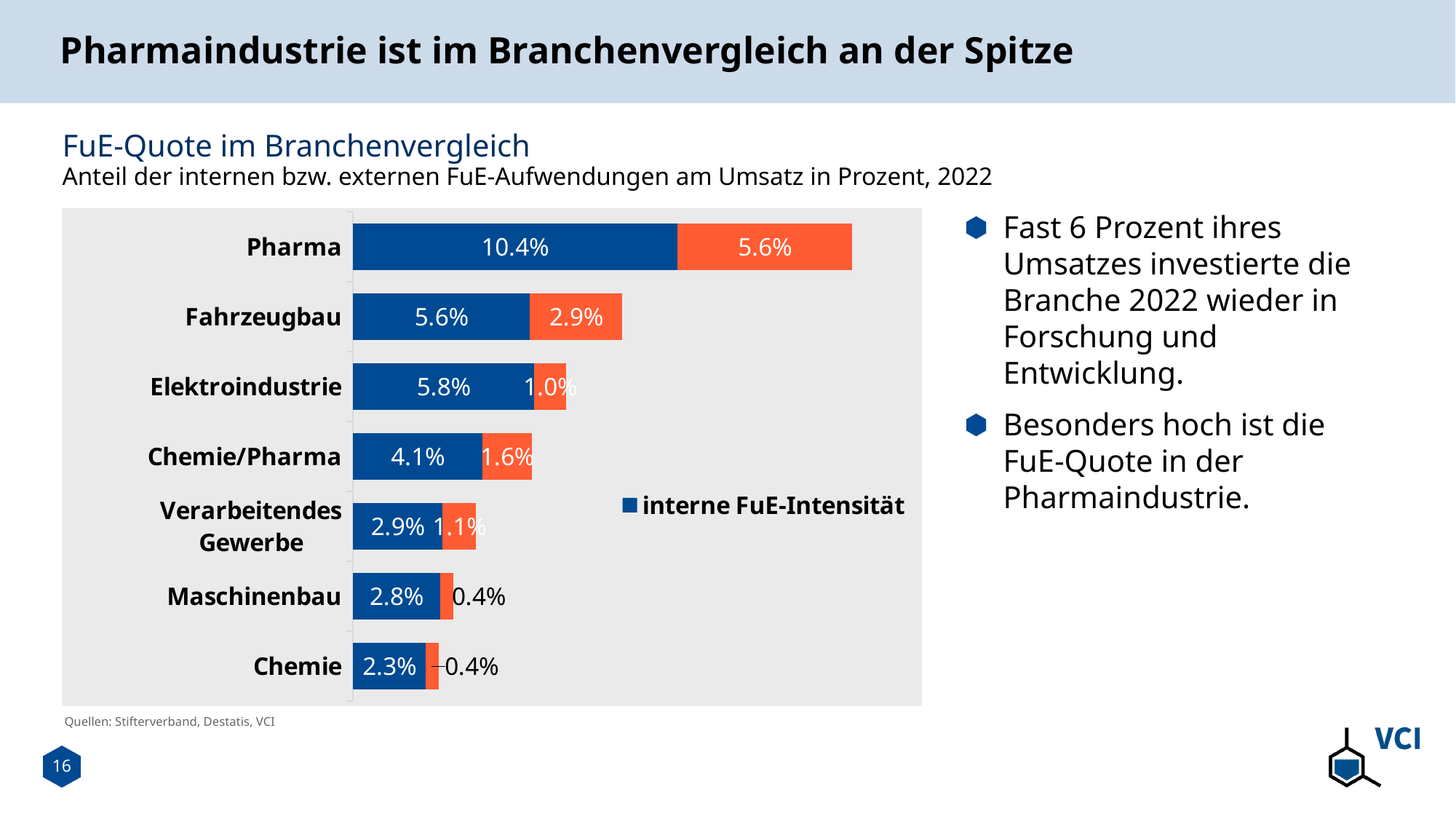
What is the title of the chart? FuE-Quote im Branchenvergleich What type of chart is shown on the slide? Bar chart Do the total bar lengths increase or decrease from the top category to the bottom category? Decrease What is the total of the two segments of the Pharma bar? 16.0% What is the difference between the interne FuE-Intensität of Pharma and Fahrzeugbau? 4.8% Which industry has the highest interne FuE-Intensität? Pharma Which industry has the lowest interne FuE-Intensität? Chemie Which has the larger interne FuE-Intensität, Elektroindustrie or Chemie/Pharma? Elektroindustrie What value is printed on the orange segment of the Fahrzeugbau bar? 2.9% How many industries are shown in the chart? 7 What is the interne FuE-Intensität value for Pharma? 10.4% What is the interne FuE-Intensität value for Verarbeitendes Gewerbe? 2.9%